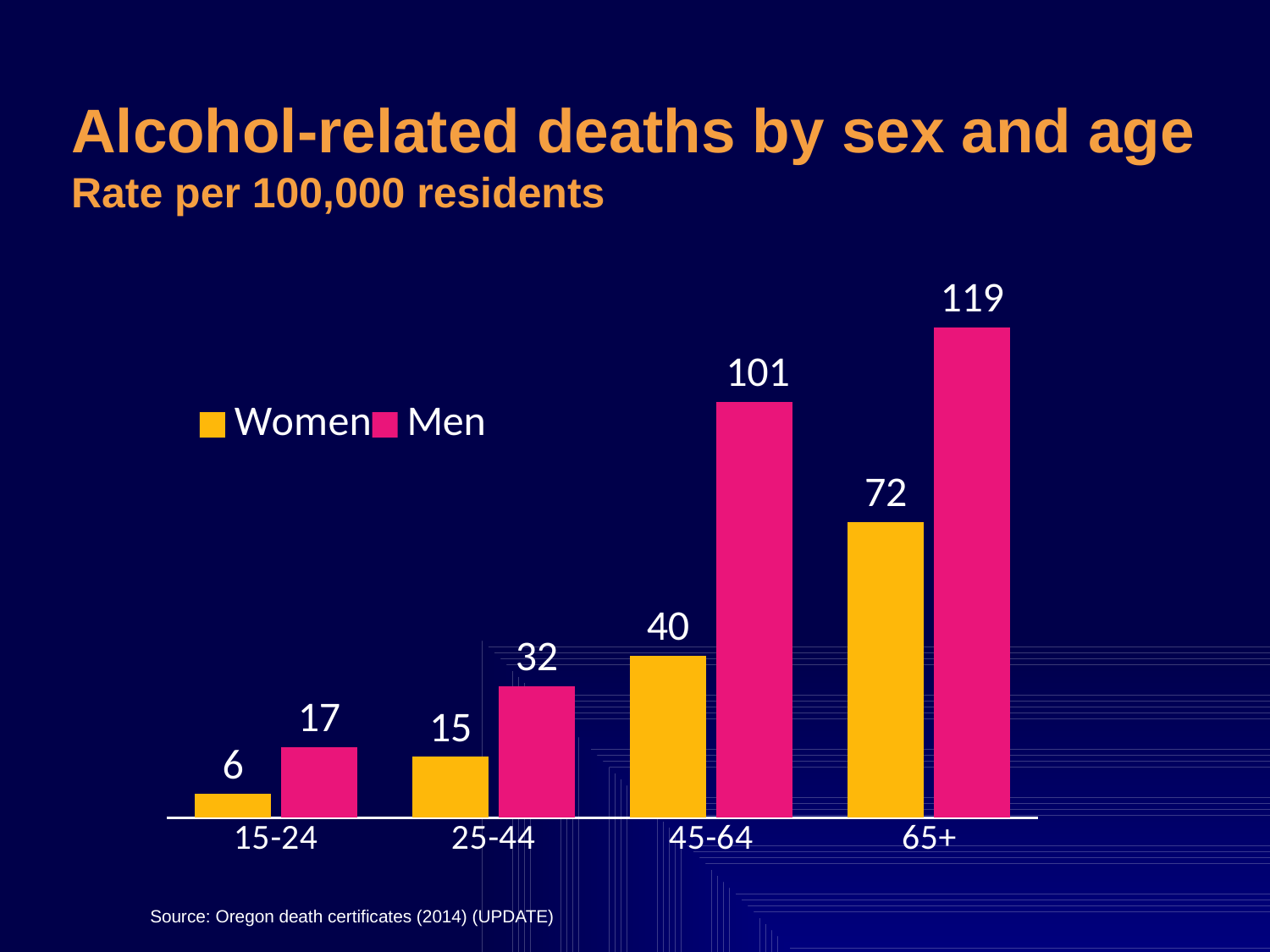
How many age groups are shown on the x axis? 4 What kind of chart is shown on the slide? Bar chart What is the alcohol-related death rate for women aged 15-24? 6 Which age group has the lowest death rate for women? 15-24 Do the men's death rates rise or fall as age increases along the x axis? Rise What is the alcohol-related death rate for men aged 25-44? 32 What is the difference between the men's and women's death rates in the 65+ age group? 47 What is the difference between the men's death rates for the 45-64 and 25-44 age groups? 69 Which age group has the highest death rate for men? 65+ How many series does the legend list? 2 Which is larger: the women's rate for 65+ or the men's rate for 45-64? Men's rate for 45-64 What is the alcohol-related death rate for women aged 45-64? 40